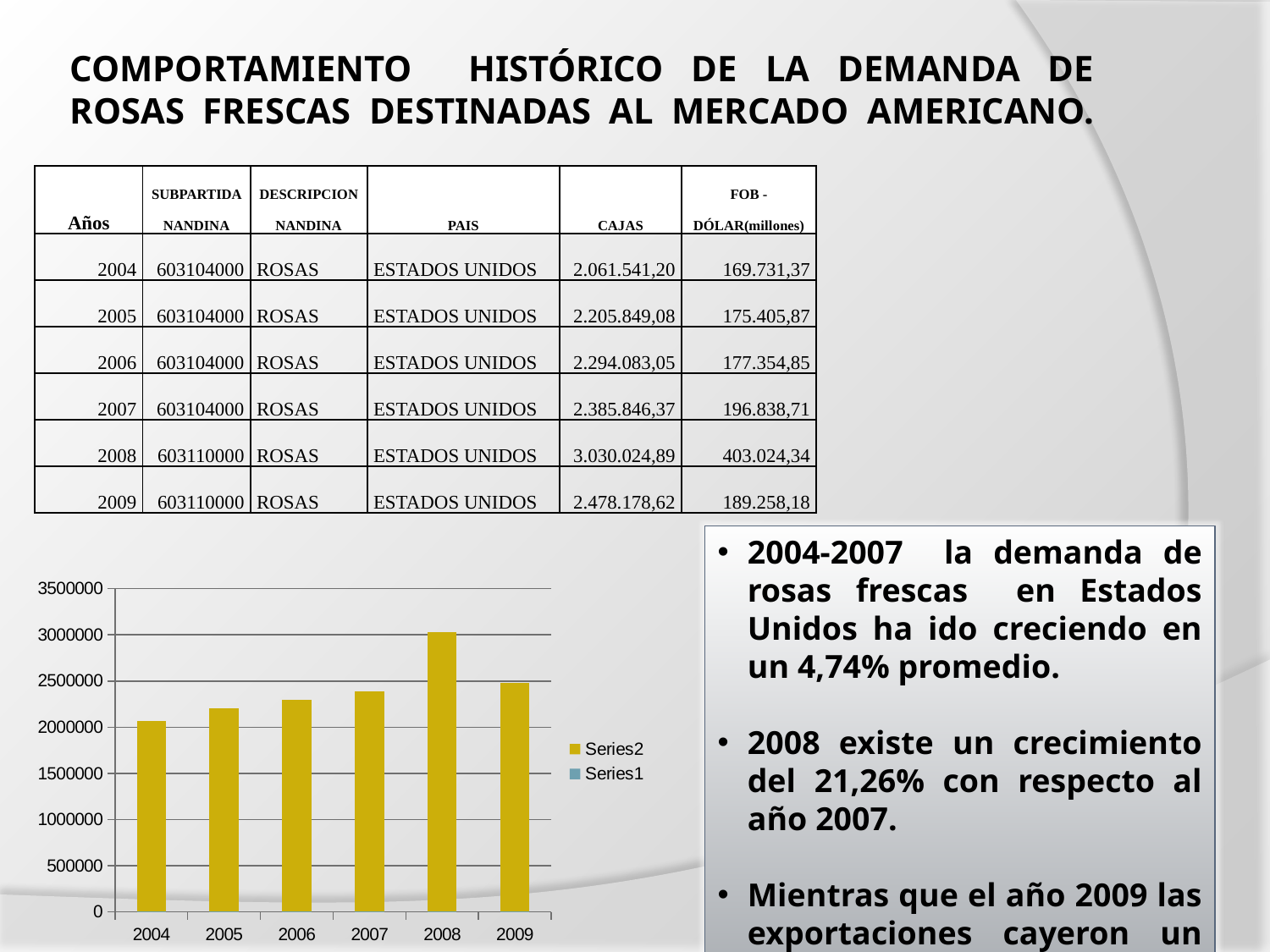
How many years are shown on the x axis of the bar chart? 6 Do the bars in the chart rise or fall from 2004 to 2008? rise In the bar chart, is the bar for 2008 taller or shorter than the bar for 2009? taller Which year has the tallest bar in the chart? 2008 Which year has the shortest bar in the chart? 2004 What kind of chart is shown at the bottom left of the slide? bar chart What are the two entries listed in the legend of the bar chart? Series2 and Series1 In the bar chart, is the bar for 2005 taller or shorter than the bar for 2007? shorter Is the value for 2009 in the bar chart greater or less than 2000000? greater Is the value for 2004 in the bar chart greater or less than 2500000? less Is the value for 2008 in the bar chart greater or less than 2500000? greater How many series does the legend of the bar chart list? 2